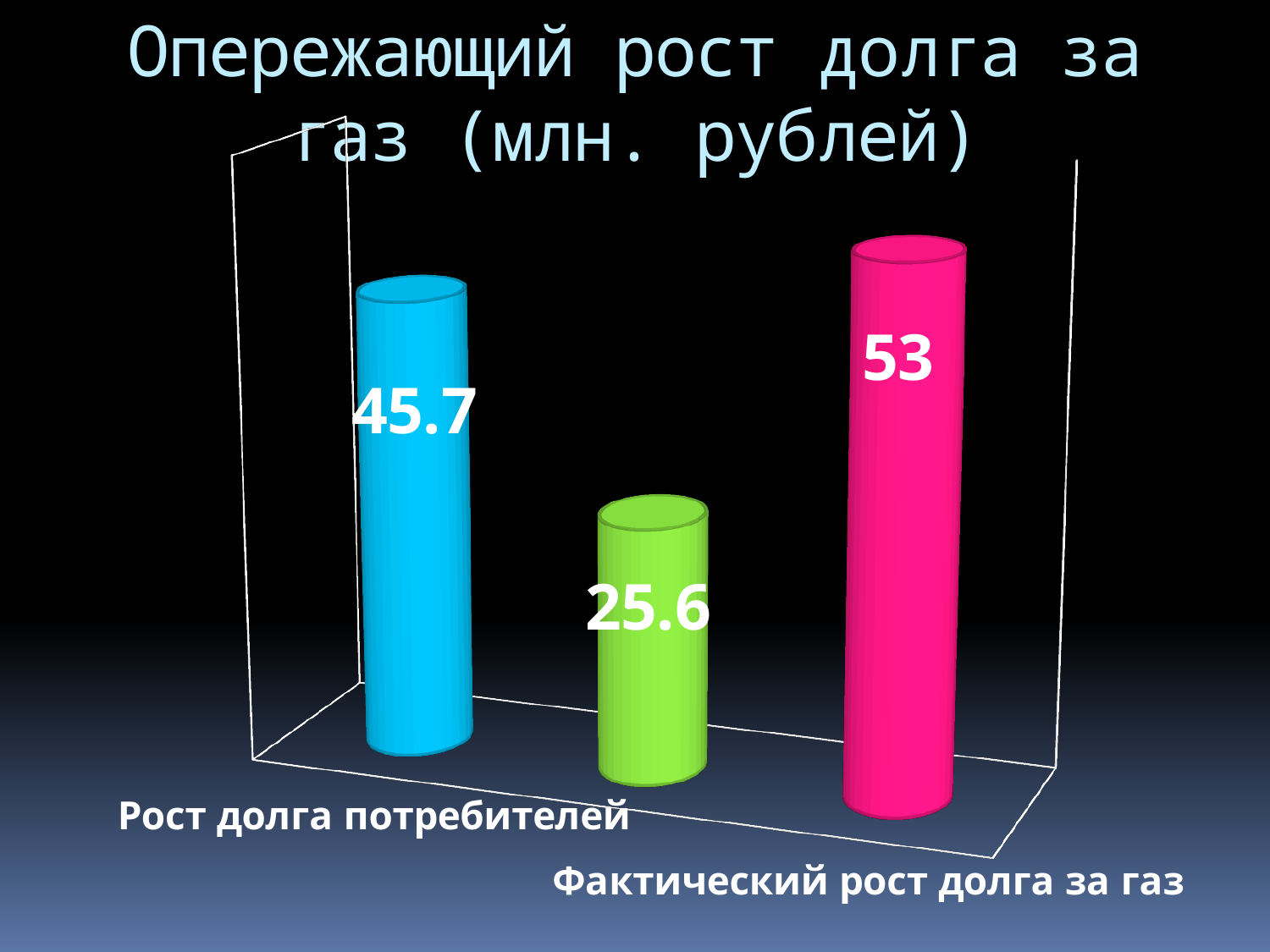
What is the lowest value shown on the chart? 25.6 What is the value for Фактический рост долга за газ? 53 How many bars are shown on the chart? 3 Which is larger, Рост долга потребителей or Фактический рост долга за газ? Фактический рост долга за газ Which category has the highest value? Фактический рост долга за газ What is the difference between Фактический рост долга за газ and Рост долга потребителей? 7.3 What kind of chart is shown on the slide? bar chart What is the difference between the blue bar (45.7) and the green bar (25.6)? 20.1 What value is printed on the green middle bar? 25.6 What is the value for Рост долга потребителей? 45.7 What is the title of the chart? Опережающий рост долга за газ (млн. рублей) What colour is the tallest bar? pink